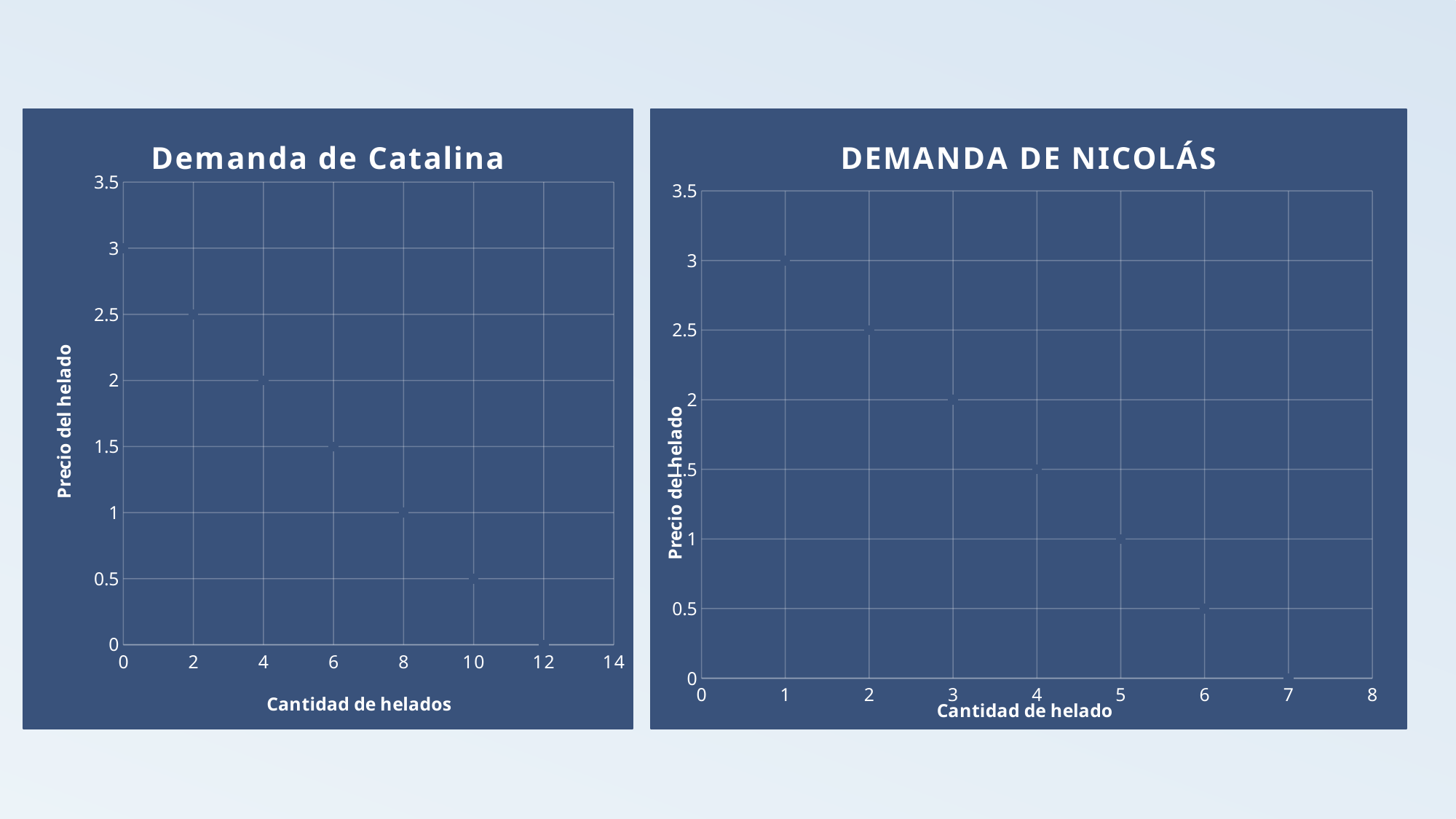
In the Demanda de Catalina chart, what is the price (Precio del helado) when the quantity is 2? 2.5 In the DEMANDA DE NICOLÁS chart, does the price rise or fall as the quantity increases along the x axis? Falls In the DEMANDA DE NICOLÁS chart, what is the price when the quantity is 5? 1 In the DEMANDA DE NICOLÁS chart, what is the price when the quantity is 1? 3 What is the title of the chart on the right? DEMANDA DE NICOLÁS In the DEMANDA DE NICOLÁS chart, which quantity has the highest price, 1 or 6? 1 In the Demanda de Catalina chart, what is the price when the quantity is 8? 1 In the DEMANDA DE NICOLÁS chart, how many data points are plotted? 7 What is the title of the chart on the left? Demanda de Catalina In the Demanda de Catalina chart, what kind of chart is shown? Scatter chart In the Demanda de Catalina chart, does the price fall or rise as the quantity of ice creams increases? Falls